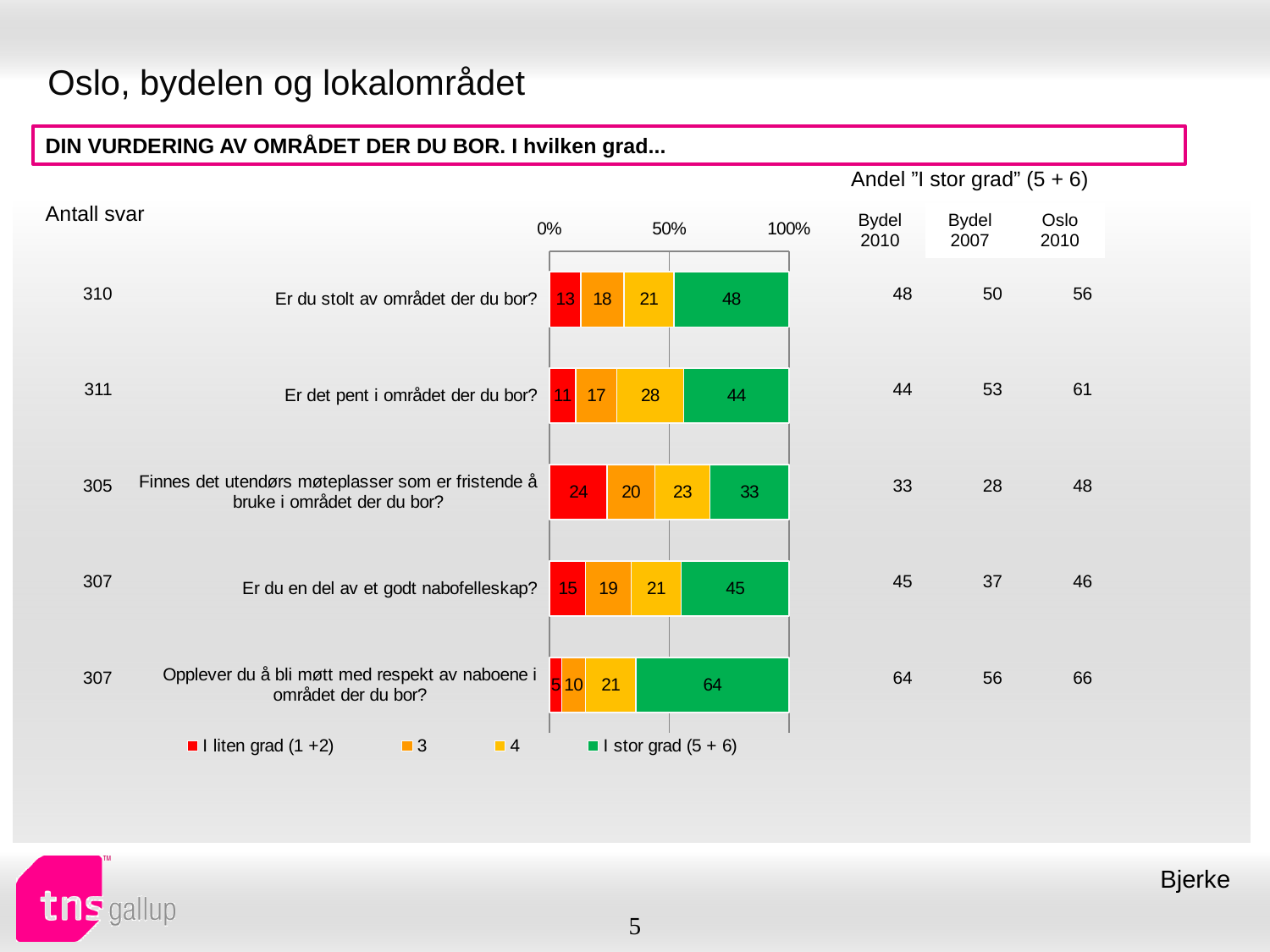
How many series does the chart legend list? 4 What is the value of "I liten grad (1 +2)" for "Finnes det utendørs møteplasser som er fristende å bruke i området der du bor?"? 24 Which is larger: the "I liten grad (1 +2)" value for "Er du en del av et godt nabofelleskap?" or for "Er det pent i området der du bor?"? Er du en del av et godt nabofelleskap? Which question has the highest "I stor grad (5 + 6)" value? Opplever du å bli møtt med respekt av naboene i området der du bor? What is the difference between the "I stor grad (5 + 6)" values for "Opplever du å bli møtt med respekt av naboene i området der du bor?" and "Er du stolt av området der du bor?"? 16 What is the value of series "4" for "Er det pent i området der du bor?"? 28 What is the value of "I stor grad (5 + 6)" for "Er du stolt av området der du bor?"? 48 How many questions (categories) are plotted in the chart? 5 What is the total of the stacked bar for "Er du en del av et godt nabofelleskap?"? 100 Which question has the lowest "I stor grad (5 + 6)" value? Finnes det utendørs møteplasser som er fristende å bruke i området der du bor? What colour represents "I stor grad (5 + 6)" in the chart? Green What type of chart is shown on the slide? Stacked bar chart